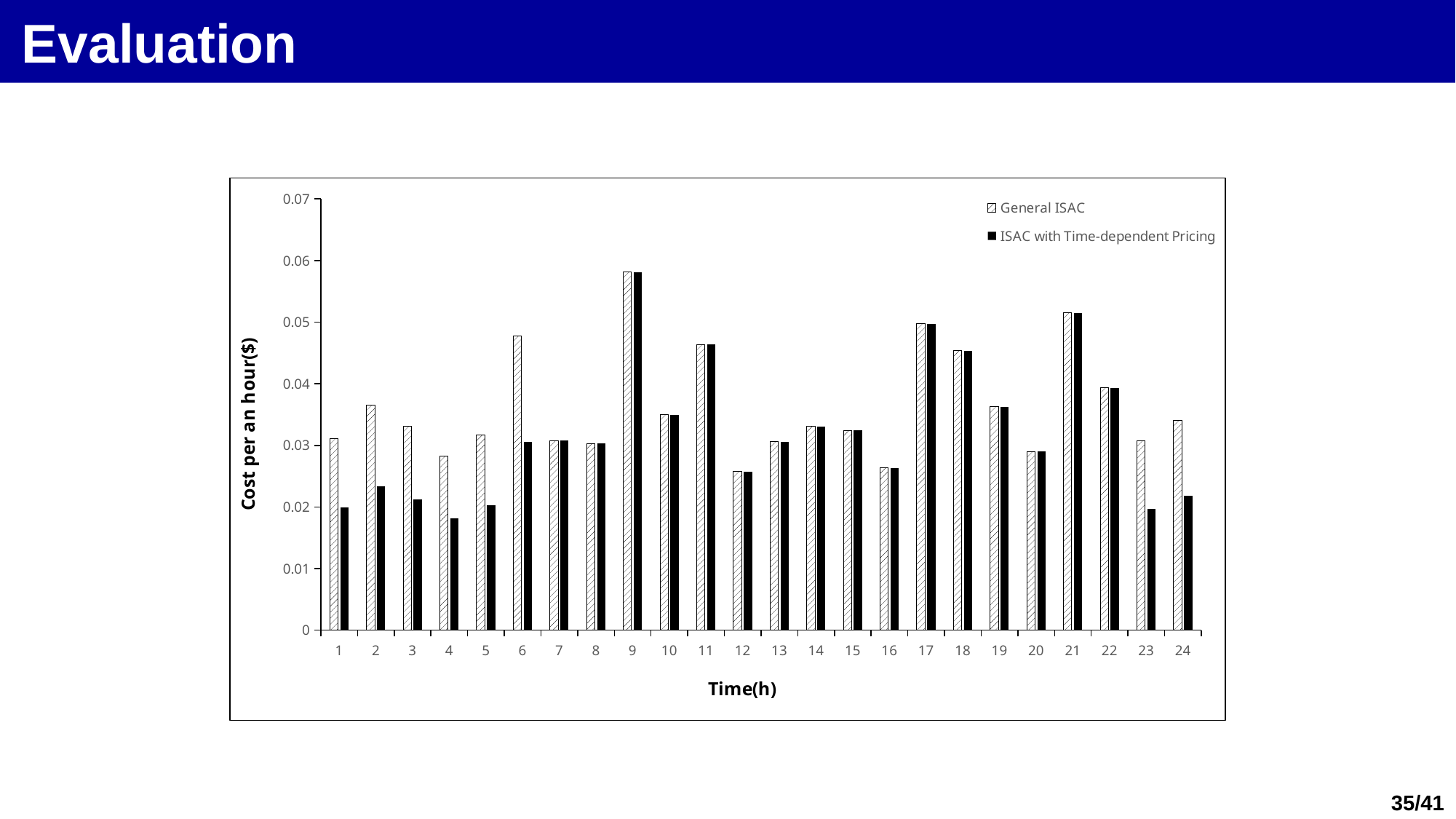
How many time points (hours) are shown on the x axis? 24 Is the ISAC with Time-dependent Pricing value at hour 4 greater or less than 0.02? less Is the General ISAC value at hour 9 greater or less than 0.05? greater What kind of chart is shown on the slide? bar chart Is the General ISAC value at hour 6 greater or less than 0.04? greater How many series does the legend list? 2 At hour 1, which series has the larger cost, General ISAC or ISAC with Time-dependent Pricing? General ISAC At which hour is the ISAC with Time-dependent Pricing cost highest? 9 At which hour is the General ISAC cost highest? 9 At hour 24, which series has the larger cost, General ISAC or ISAC with Time-dependent Pricing? General ISAC At which hour is the ISAC with Time-dependent Pricing cost lowest? 4 What is the title of the y axis? Cost per an hour($)